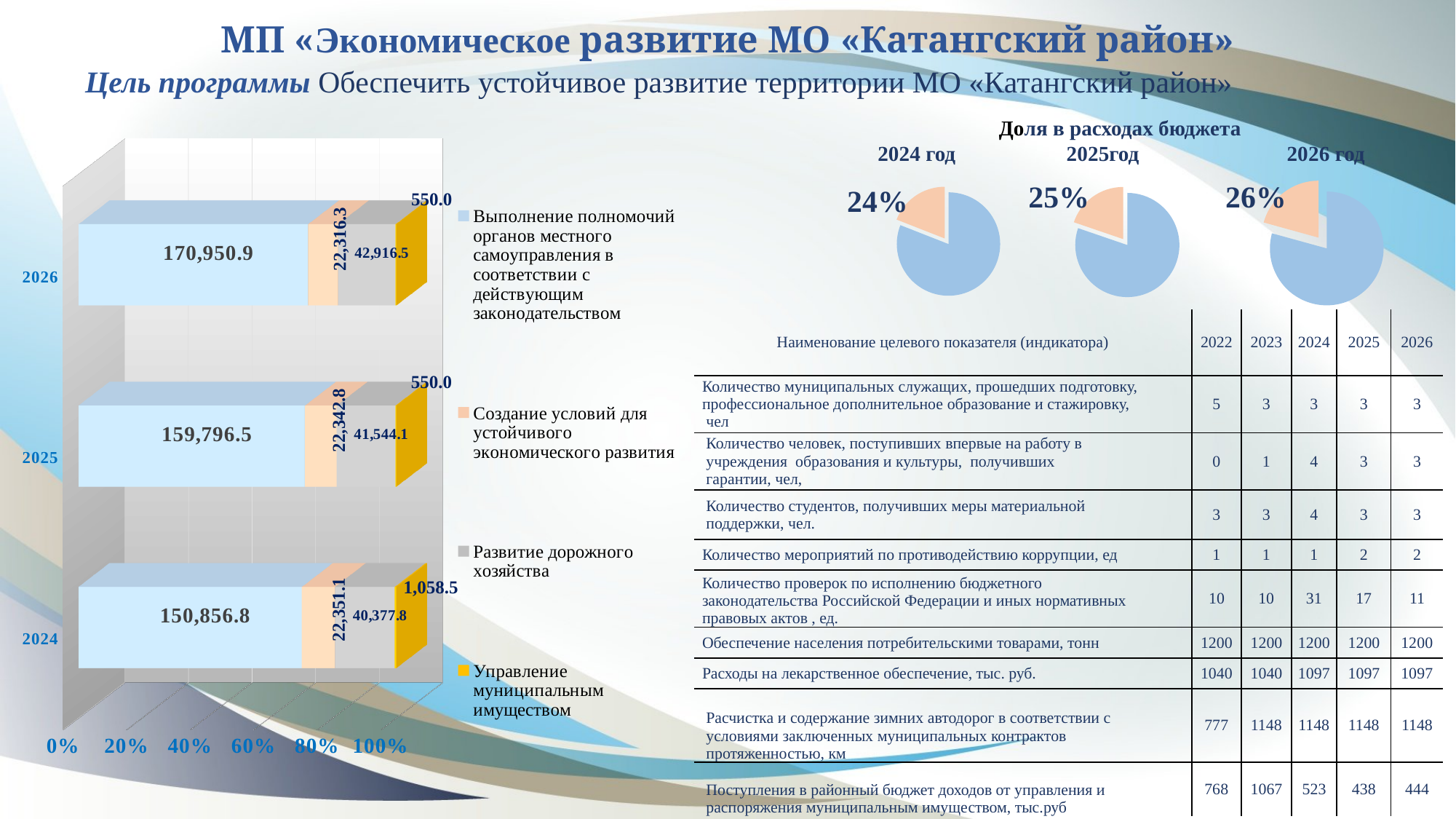
In the stacked bar chart on the left, what is the value for «Развитие дорожного хозяйства» in 2024? 40,377.8 In the stacked bar chart on the left, what is the value for «Управление муниципальным имуществом» in 2024? 1,058.5 In the stacked bar chart on the left, how many years are shown on the vertical axis? 3 In the stacked bar chart on the left, how many series does the legend list? 4 In the pie charts under «Доля в расходах бюджета», what share is shown for 2025 год? 25% In the pie charts under «Доля в расходах бюджета», does the share rise or fall from 2024 год to 2026 год? rises In the stacked bar chart on the left, what is the value for «Выполнение полномочий органов местного самоуправления в соответствии с действующим законодательством» in 2026? 170,950.9 In the stacked bar chart on the left, what is the difference between the 2026 and 2025 values for «Выполнение полномочий органов местного самоуправления»? 11,154.4 What kind of chart is the chart on the left of the slide? bar chart In the stacked bar chart on the left, which year has the highest value for «Выполнение полномочий органов местного самоуправления»? 2026 In the stacked bar chart on the left, is the value for «Управление муниципальным имуществом» larger in 2024 or in 2025? 2024 In the stacked bar chart on the left, what is the total of the 2024 bar? 214,644.2